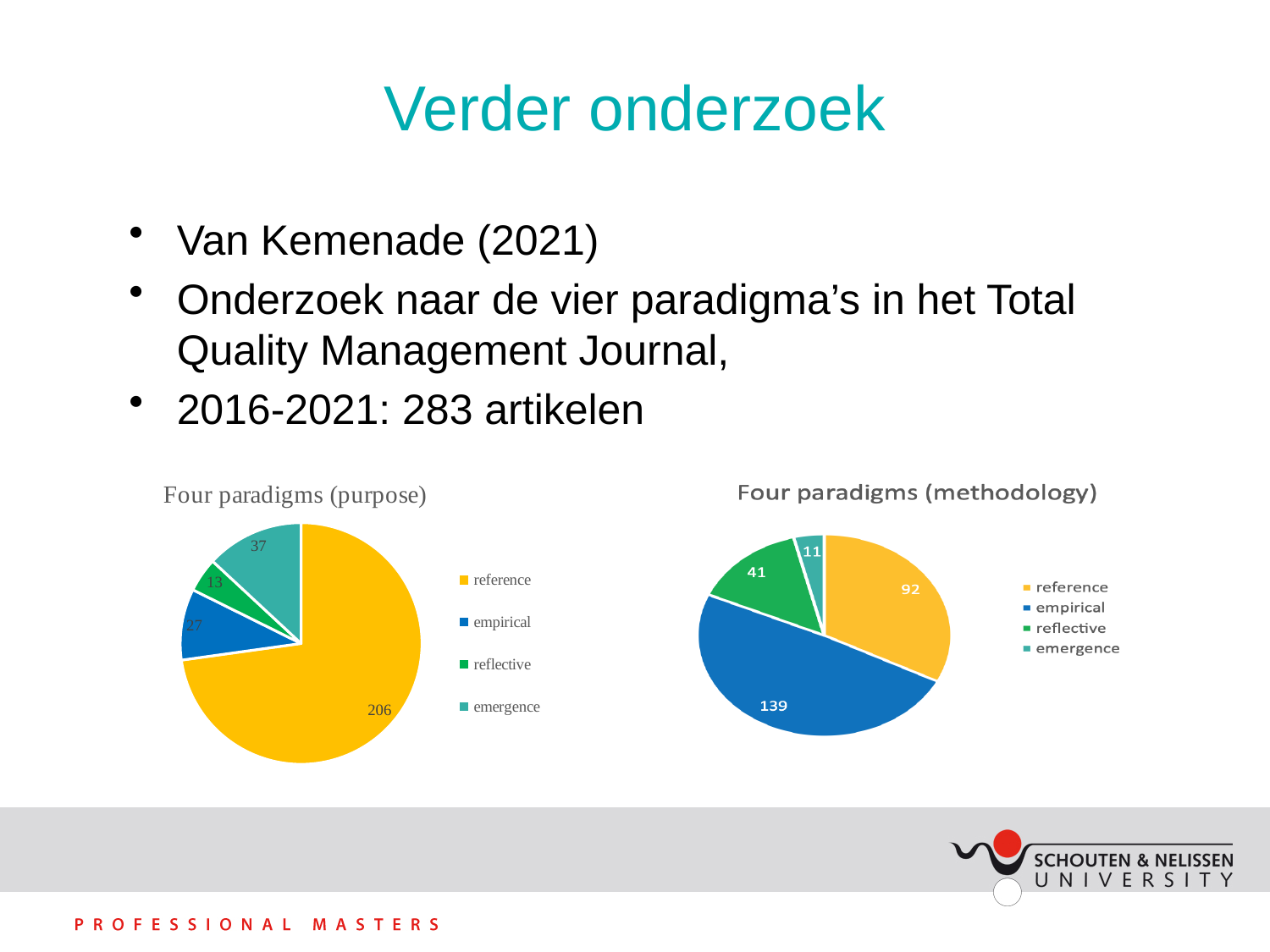
In the 'Four paradigms (methodology)' chart, which category has the largest slice? empirical In the 'Four paradigms (purpose)' chart, which is larger: emergence or empirical? emergence In the 'Four paradigms (methodology)' chart, what is the value for reflective? 41 In the 'Four paradigms (methodology)' chart, which category has the smallest slice? emergence In the 'Four paradigms (purpose)' chart, what is the difference between the reference and empirical values? 179 How many slices does the 'Four paradigms (methodology)' pie chart have? 4 In the 'Four paradigms (methodology)' chart, what is the difference between the empirical and reference values? 47 In the 'Four paradigms (purpose)' chart, which category has the smallest slice? reflective In the 'Four paradigms (methodology)' chart, what is the value for empirical? 139 In the 'Four paradigms (purpose)' chart, what is the value for reference? 206 What type of chart is 'Four paradigms (purpose)'? pie chart In the 'Four paradigms (purpose)' chart, what is the value for emergence? 37